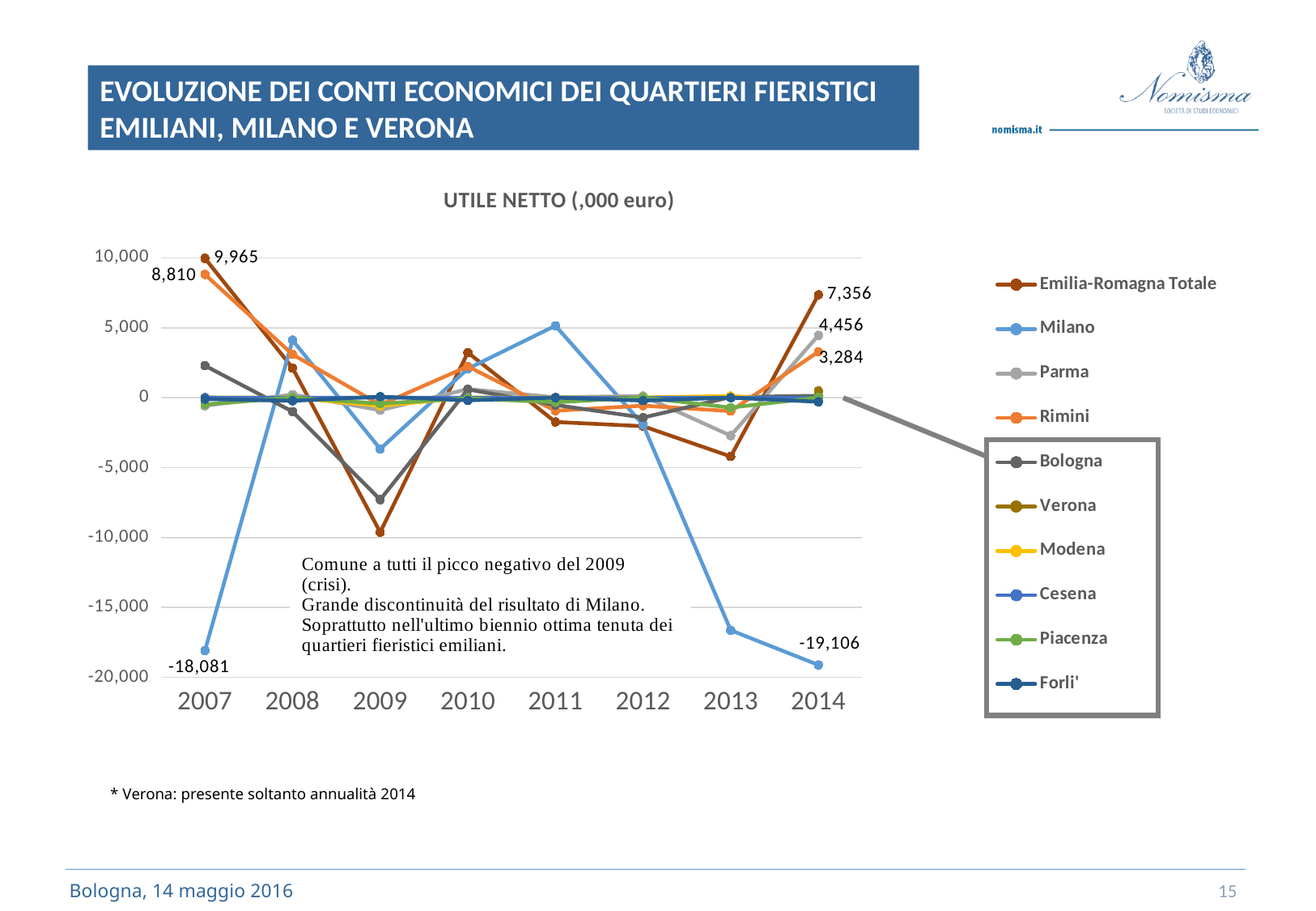
What is the title of the chart? UTILE NETTO (,000 euro) How many years are shown on the x axis? 8 Is the value for Emilia-Romagna Totale in 2009 greater or less than -5,000? less What is the value for Milano in 2014? -19,106 What is the value for Milano in 2007? -18,081 What is the value for Emilia-Romagna Totale in 2007? 9,965 What is the difference between the Emilia-Romagna Totale values in 2007 and 2014? 2,609 What is the value for Parma in 2014? 4,456 What is the value for Rimini in 2014? 3,284 Which is lower for Milano, the value in 2007 or the value in 2014? 2014 How many series does the legend list? 10 What kind of chart is shown on the slide? line chart